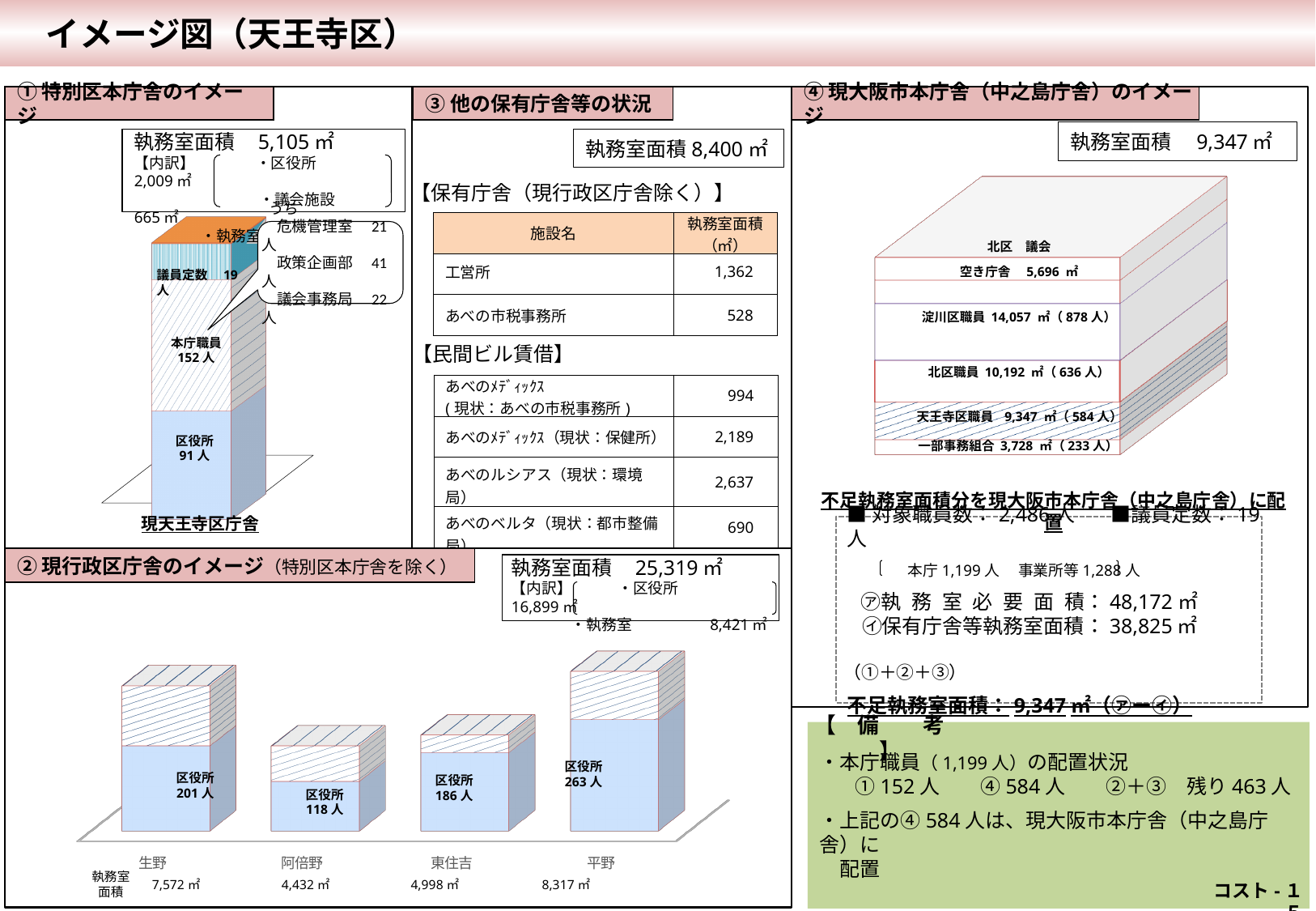
In section ④ (現大阪市本庁舎のイメージ), which group has the smallest 執務室面積? 一部事務組合 In section ② (現行政区庁舎のイメージ), what is the difference in 区役所 staff between 生野 and 東住吉? 15 人 In section ② (現行政区庁舎のイメージ), which has the larger 執務室面積, 生野 or 東住吉? 生野 In section ④ (現大阪市本庁舎のイメージ), what 執務室面積 is shown for 淀川区職員? 14,057 ㎡ In section ② (現行政区庁舎のイメージ), which ward has the smallest 執務室面積? 阿倍野 In section ② (現行政区庁舎のイメージ), what is the 執務室面積 shown for 阿倍野? 4,432 ㎡ In section ① (特別区本庁舎のイメージ), how many 本庁職員 are shown? 152 人 In section ② (現行政区庁舎のイメージ), how many 区役所 staff are shown for 平野? 263 人 In section ② (現行政区庁舎のイメージ), which ward has the largest 区役所 staff count? 平野 In section ③ (他の保有庁舎等の状況), what is the 執務室面積 for 工営所? 1,362 In section ② (現行政区庁舎のイメージ), how many wards are shown? 4 In section ④ (現大阪市本庁舎のイメージ), how many staff are shown for 北区職員? 636 人